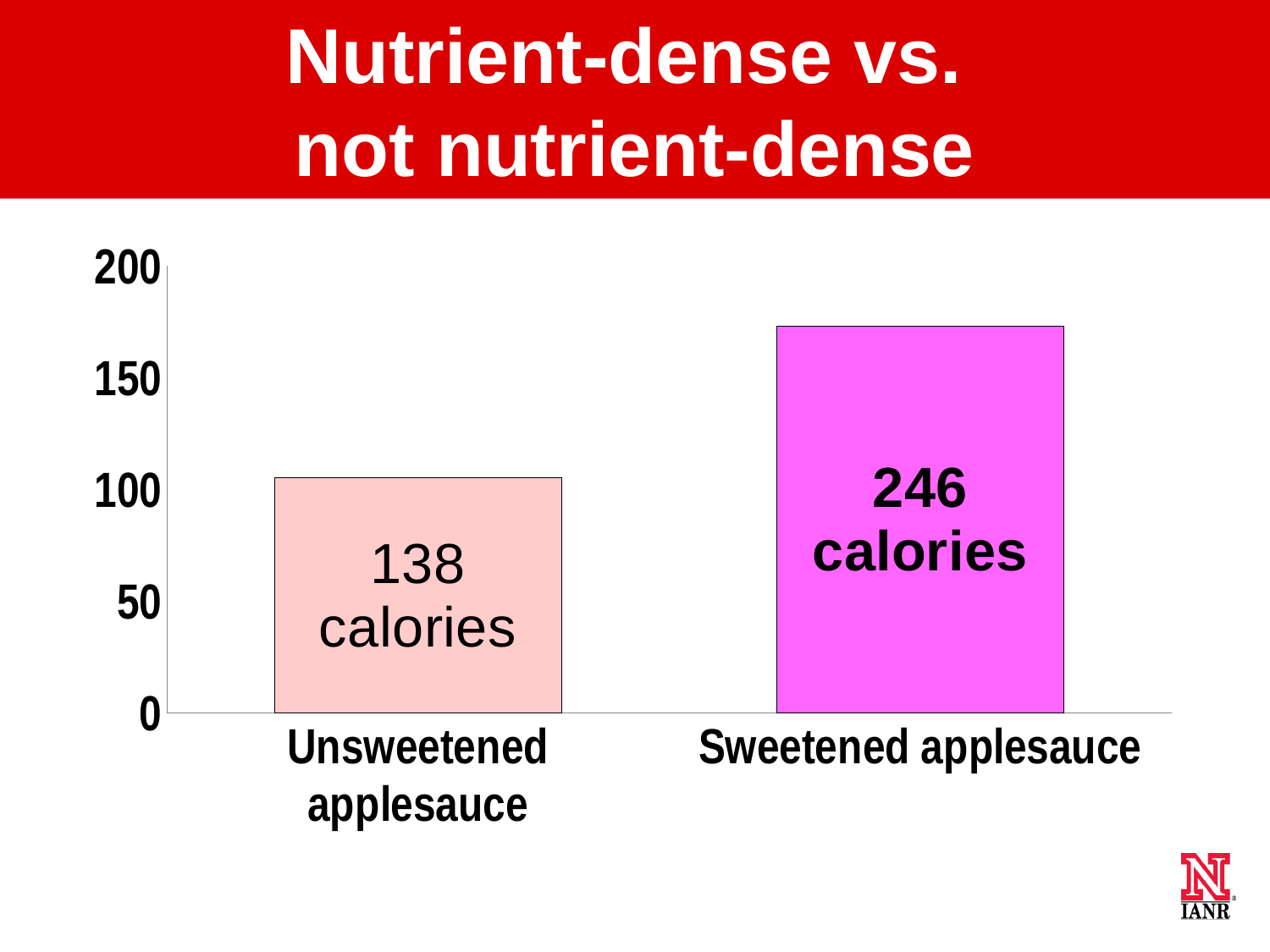
What is the highest value shown on the vertical axis? 200 Which has more calories, sweetened applesauce or unsweetened applesauce? Sweetened applesauce How many categories are shown on the chart? 2 What is the difference in calories between sweetened applesauce and unsweetened applesauce? 108 calories Which category has the higher calorie value? Sweetened applesauce Is the value for unsweetened applesauce greater or less than 100? greater Is the value for sweetened applesauce greater or less than 150? greater Which category has the lower calorie value? Unsweetened applesauce What kind of chart is shown on the slide? Bar chart What is the title of the slide? Nutrient-dense vs. not nutrient-dense How many calories does the chart show for unsweetened applesauce? 138 calories How many calories does the chart show for sweetened applesauce? 246 calories